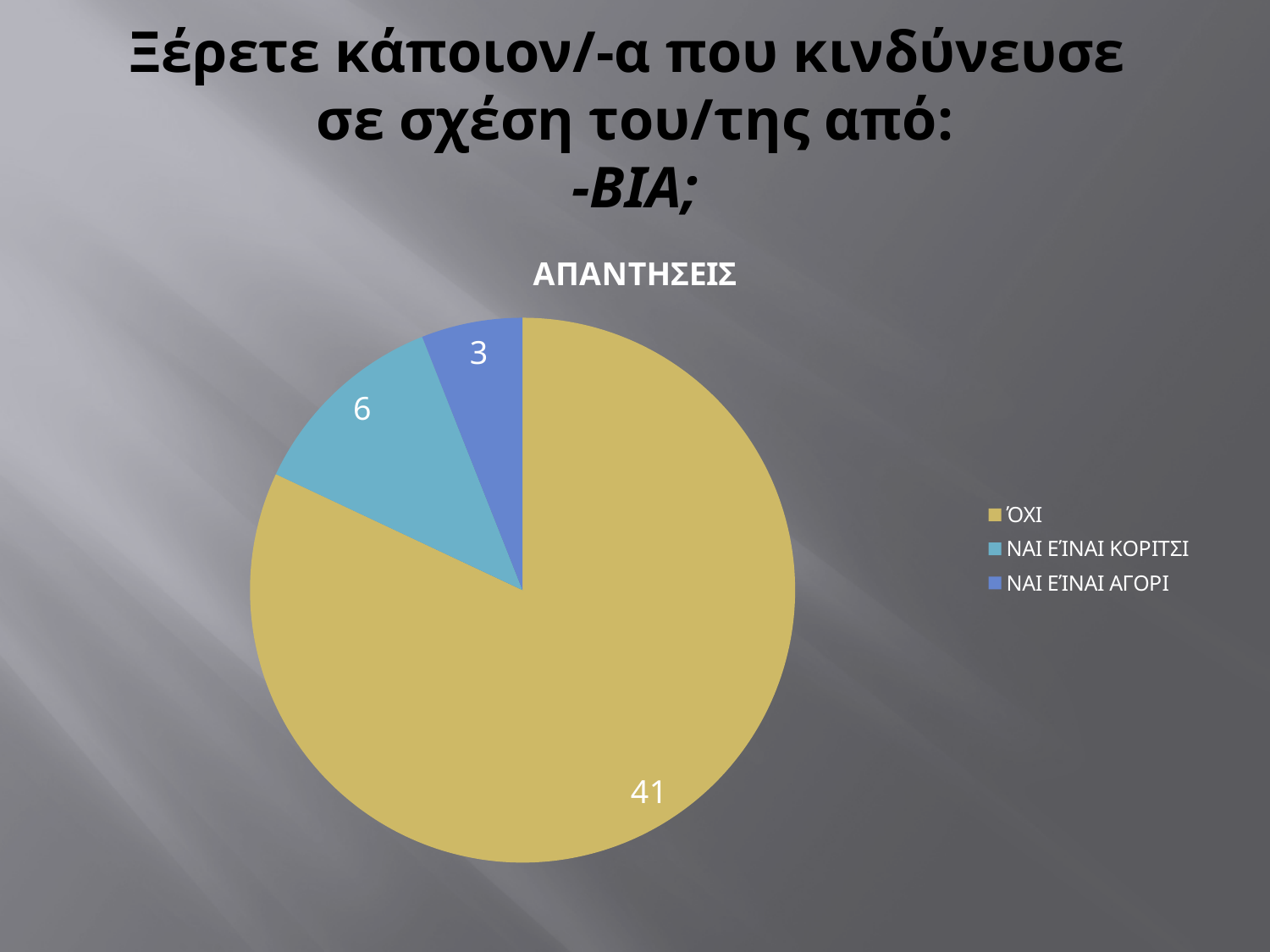
What is the difference between the values for ΝΑΙ ΕΊΝΑΙ ΚΟΡΙΤΣΙ and ΝΑΙ ΕΊΝΑΙ ΑΓΟΡΙ? 3 What share of the pie does ΌΧΙ represent? 82% What is the value for ΝΑΙ ΕΊΝΑΙ ΚΟΡΙΤΣΙ? 6 What is the difference between the values for ΌΧΙ and ΝΑΙ ΕΊΝΑΙ ΚΟΡΙΤΣΙ? 35 Which category has the largest slice? ΌΧΙ How many categories does the pie chart have? 3 Which category has the smallest slice? ΝΑΙ ΕΊΝΑΙ ΑΓΟΡΙ Which is larger, the value for ΝΑΙ ΕΊΝΑΙ ΚΟΡΙΤΣΙ or the value for ΝΑΙ ΕΊΝΑΙ ΑΓΟΡΙ? ΝΑΙ ΕΊΝΑΙ ΚΟΡΙΤΣΙ What type of chart is shown on the slide? pie chart What is the title of the chart? ΑΠΑΝΤΗΣΕΙΣ What is the value for ΝΑΙ ΕΊΝΑΙ ΑΓΟΡΙ? 3 What is the value for ΌΧΙ? 41